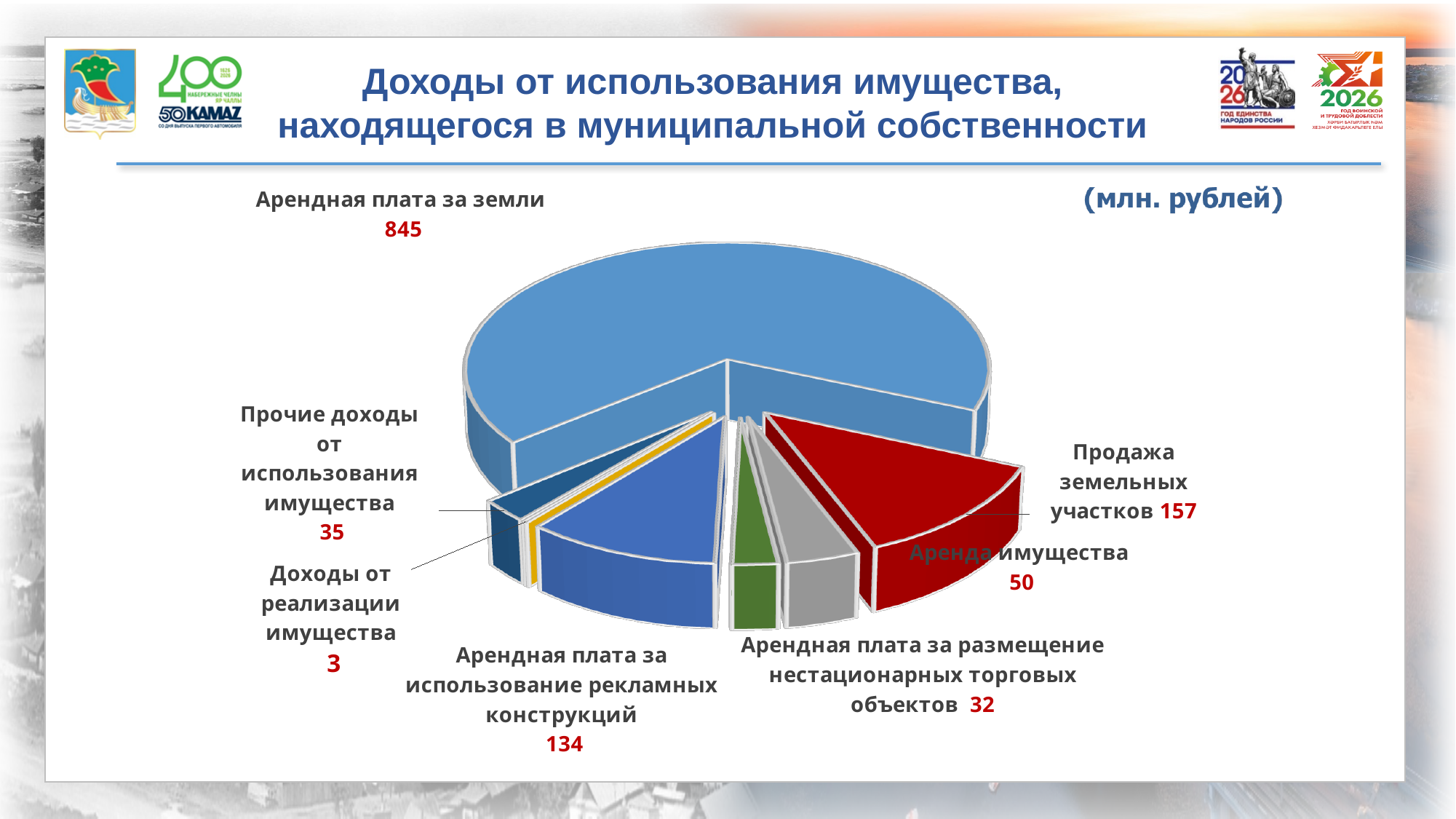
What is the value for Продажа земельных участков? 157 What is the value for Арендная плата за размещение нестационарных торговых объектов? 32 Which category has the smallest value in the pie chart? Доходы от реализации имущества What is the difference between Продажа земельных участков and Аренда имущества? 107 In what units are the values on the chart given? млн. рублей What is the value for Арендная плата за использование рекламных конструкций? 134 What kind of chart is shown on the slide? pie chart What is the value for Арендная плата за земли? 845 Which is larger: Прочие доходы от использования имущества or Арендная плата за размещение нестационарных торговых объектов? Прочие доходы от использования имущества What is the value for Доходы от реализации имущества? 3 Which category has the largest value in the pie chart? Арендная плата за земли How many slices does the pie chart have? 7